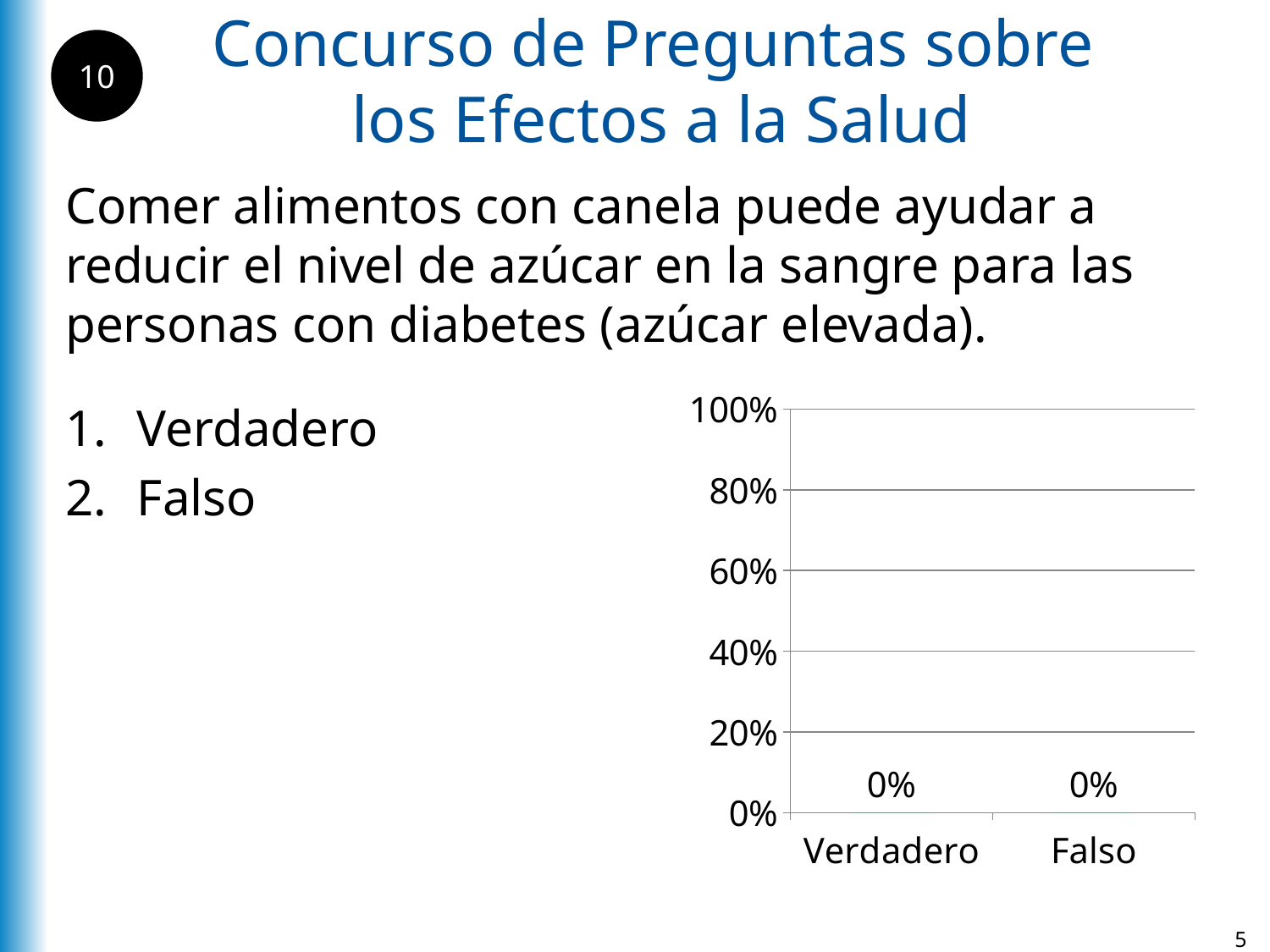
What are the two category labels on the x axis of the chart? Verdadero and Falso What kind of chart is shown on the slide? bar chart How many categories are shown on the x axis of the chart? 2 What is the value shown for Falso in the chart? 0% What is the value shown for Verdadero in the chart? 0% What is the highest value labelled on the y axis of the chart? 100% Is the value for Verdadero greater or less than 20%? less Is the value for Falso greater or less than 40%? less What is the difference between the values for Verdadero and Falso? 0%